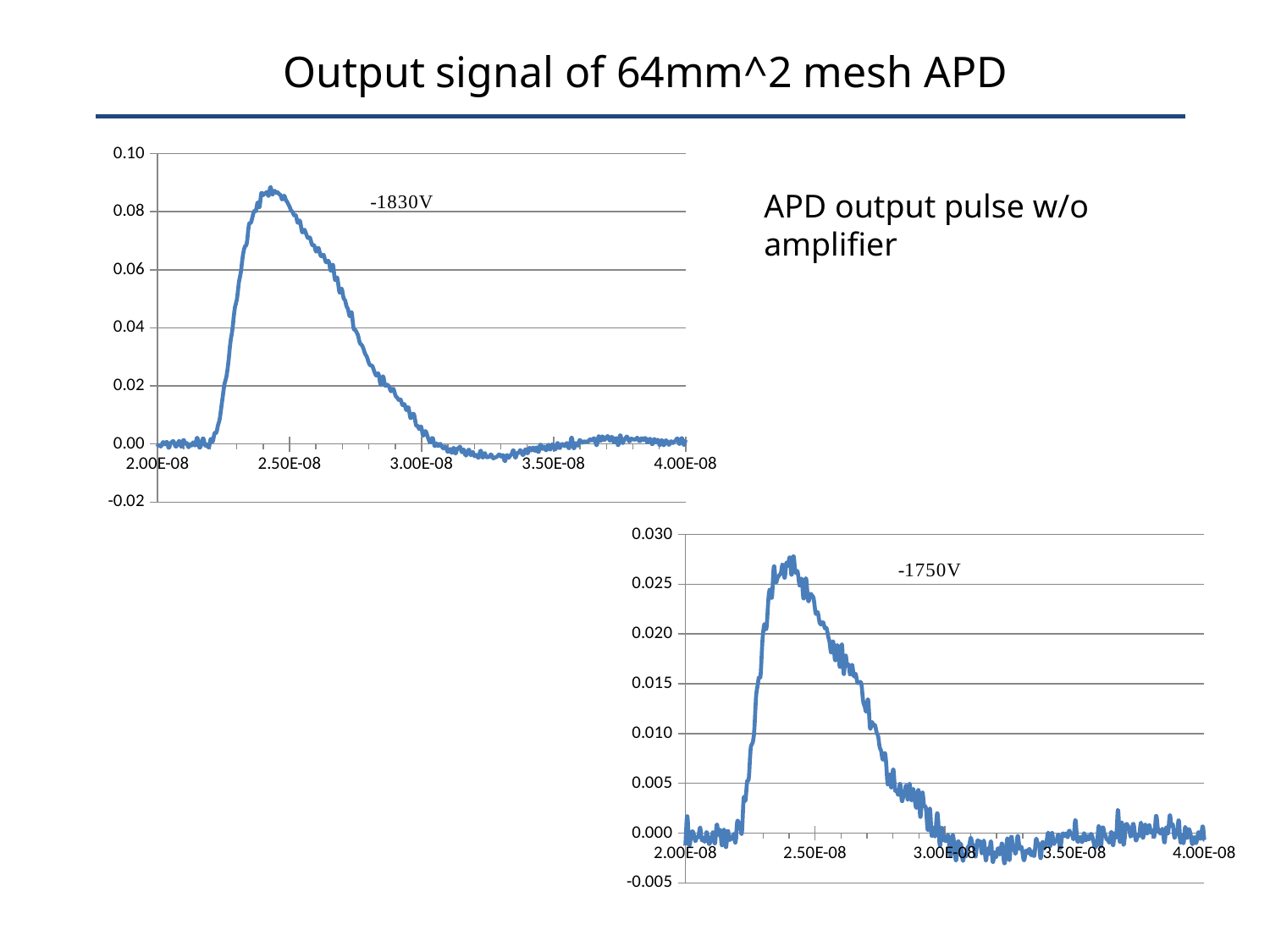
In the lower-right chart labelled -1750V, is the value at 3.00E-08 greater or less than 0.005? less In the lower-right chart labelled -1750V, does the signal rise or fall between 2.00E-08 and 2.50E-08 on the x axis? rise What kind of chart is the lower-right chart labelled -1750V? line chart In the lower-right chart labelled -1750V, is the peak value of the pulse greater or less than 0.025? greater What voltage label is printed inside the lower-right chart? -1750V What is the highest value shown on the y axis of the upper-left chart labelled -1830V? 0.10 What kind of chart is the upper-left chart labelled -1830V? line chart In the upper-left chart labelled -1830V, is the peak value of the pulse greater or less than 0.08? greater How many charts are shown on the slide? 2 Which chart shows the higher peak pulse value, the one labelled -1830V or the one labelled -1750V? -1830V In the upper-left chart labelled -1830V, does the signal rise or fall between 2.50E-08 and 3.00E-08 on the x axis? fall